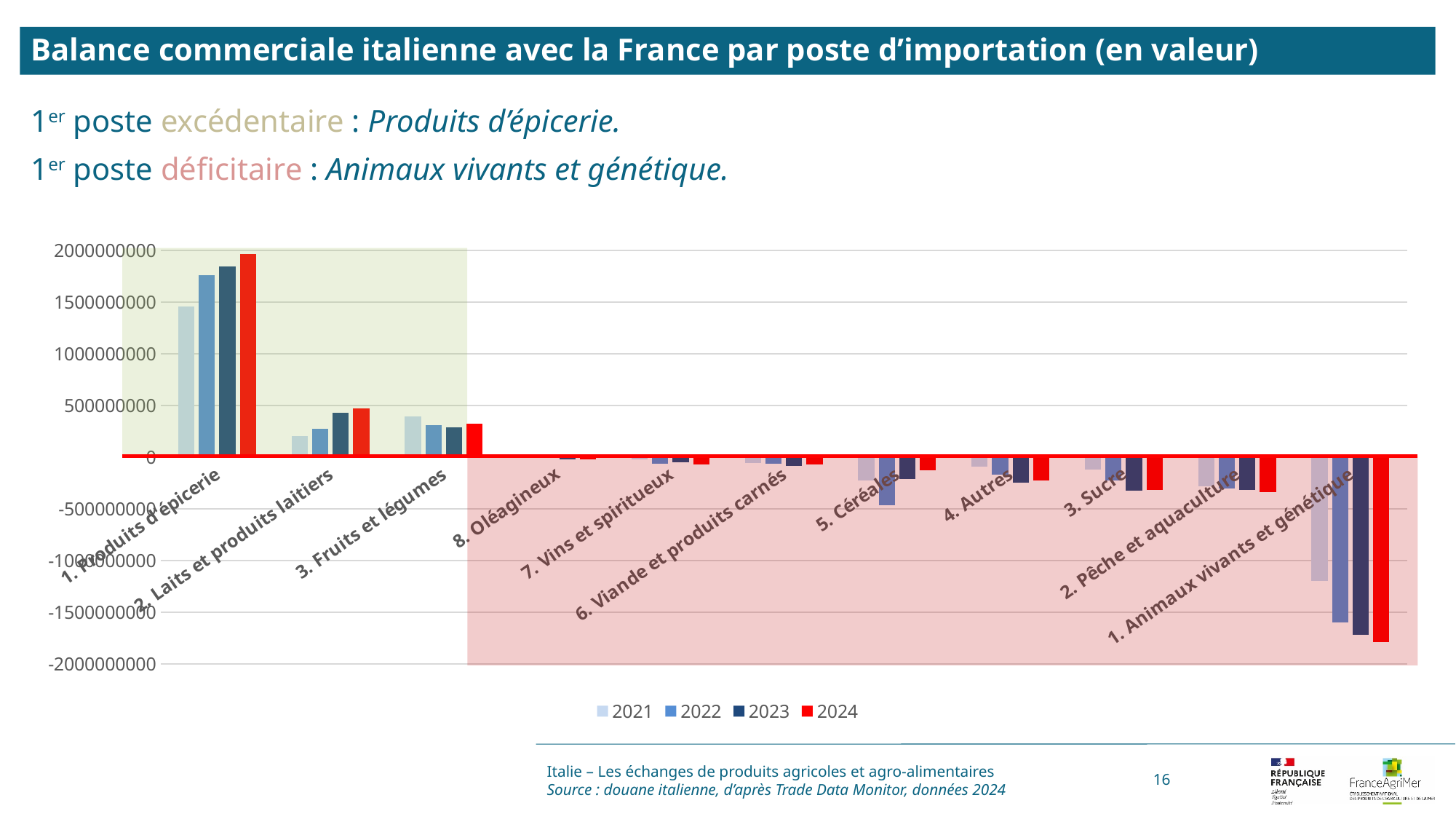
What colour represents the 2024 series in the legend? red For 1. Produits d'épicerie, do the values rise or fall from 2021 to 2024? rise Which category has the highest 2024 value? 1. Produits d'épicerie Is the 2024 value for 1. Produits d'épicerie greater or less than 1500000000? greater How many series does the legend list? 4 How many import categories are shown on the x axis? 11 Which category has the lowest (most negative) 2024 value? 1. Animaux vivants et génétique Is the 2024 value for 1. Animaux vivants et génétique greater or less than -1500000000? less For 1. Animaux vivants et génétique, do the values rise or fall from 2021 to 2024? fall Which is larger in 2024: 2. Laits et produits laitiers or 3. Fruits et légumes? 2. Laits et produits laitiers What kind of chart is shown on the slide? bar chart